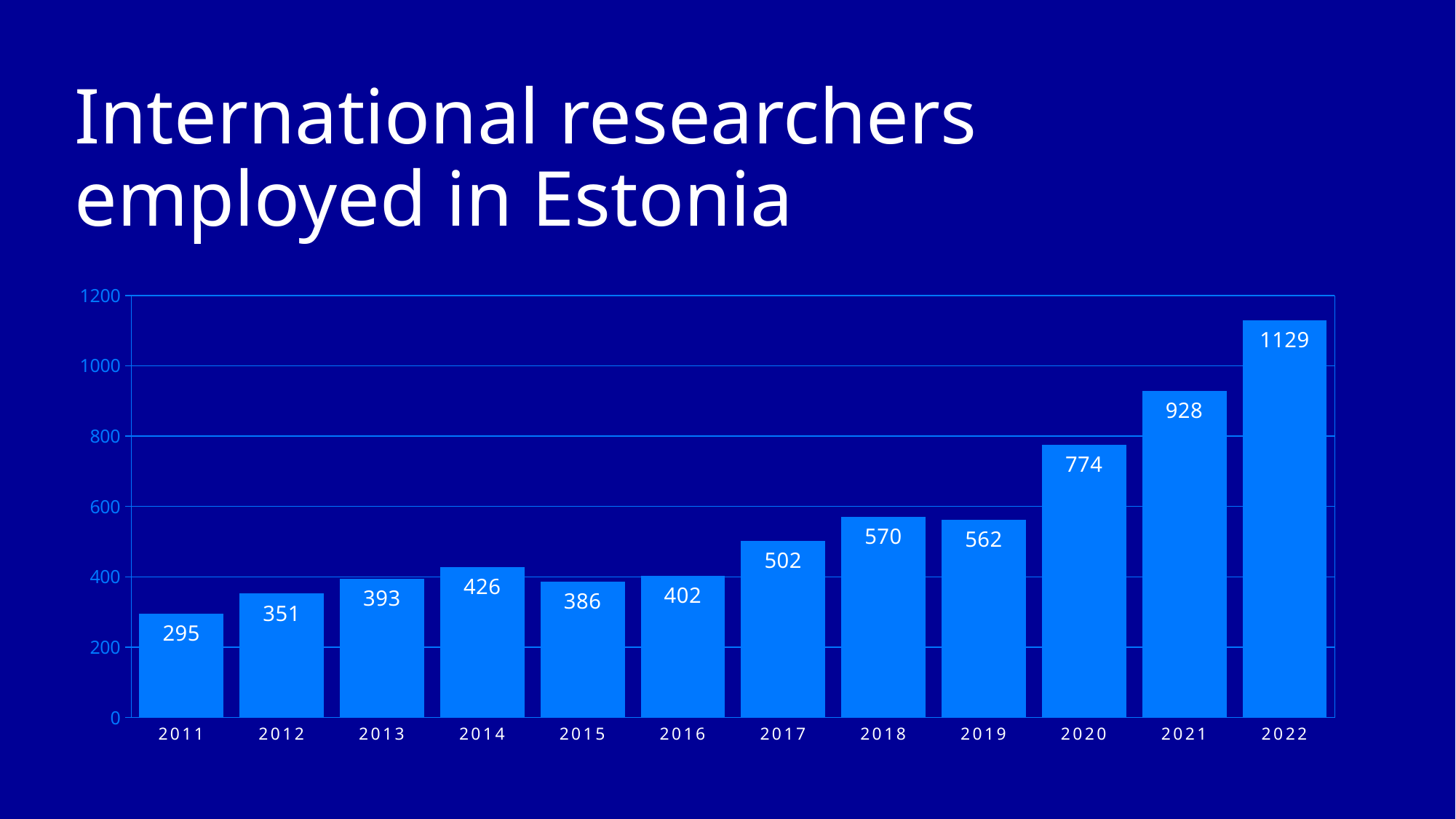
How many years are shown on the x axis? 12 Which year has the highest value? 2022 Is the value for 2020 greater or less than 600? greater What is the value for 2022? 1129 What is the title of the slide? International researchers employed in Estonia What is the value for 2011? 295 What kind of chart is shown on the slide? bar chart Which is larger, the value for 2018 or the value for 2019? 2018 What is the difference between the values for 2020 and 2019? 212 What is the difference between the values for 2022 and 2021? 201 Which year has the lowest value? 2011 What is the value for 2017? 502